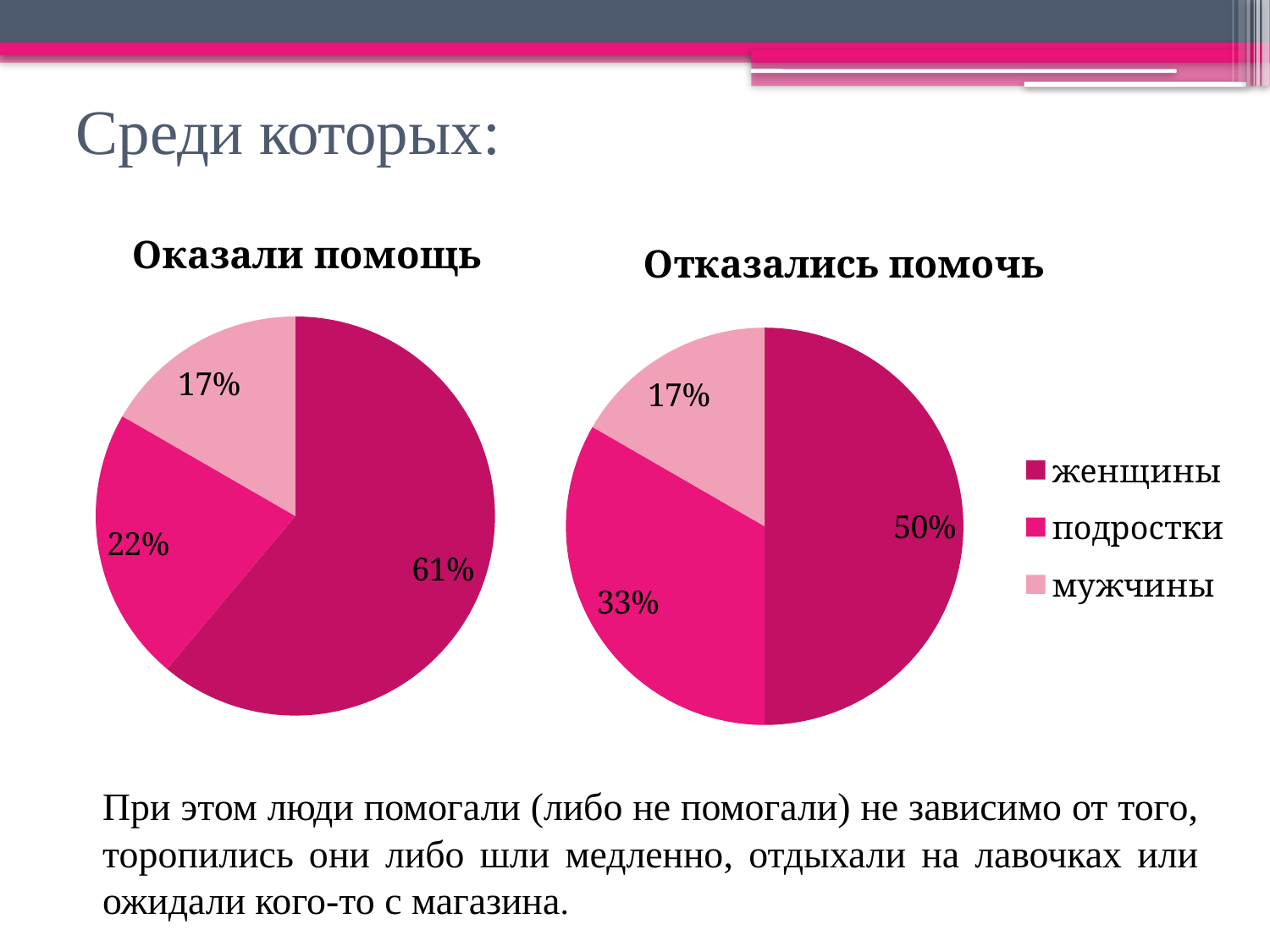
In the "Оказали помощь" chart, what share is shown for подростки? 22% What is the title of the chart on the right? Отказались помочь In the "Отказались помочь" chart, what share is shown for подростки? 33% How many entries does the legend list? 3 In the "Отказались помочь" chart, what share is shown for мужчины? 17% What type of chart is "Оказали помощь"? pie chart In the "Отказались помочь" chart, which category has the smallest slice? мужчины Which is larger: the share for подростки in the "Оказали помощь" chart or in the "Отказались помочь" chart? Отказались помочь In the "Оказали помощь" chart, what is the difference between the shares for женщины and подростки? 39% In the "Оказали помощь" chart, which category has the largest slice? женщины In the "Оказали помощь" chart, what share is shown for женщины? 61% How many slices does the "Отказались помочь" chart have? 3